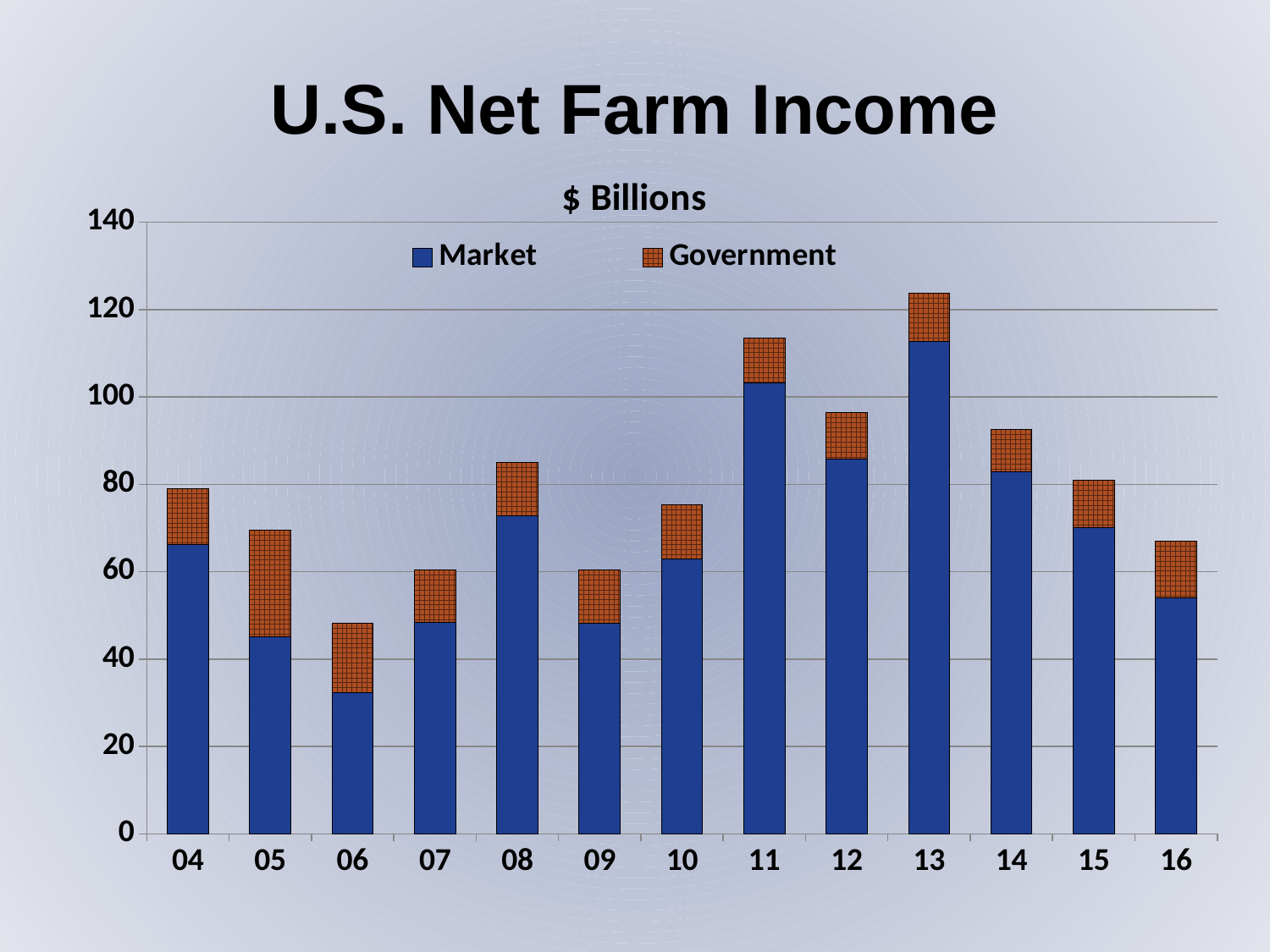
Is the total value for 13 greater or less than 120? greater What kind of chart is shown on the slide? bar chart Which year has the larger total, 11 or 12? 11 Which year has the highest total net farm income? 13 Which year has the lowest total net farm income? 06 Do the total values rise or fall from 13 to 16? fall How many series does the legend list? 2 Is the total value for 06 greater or less than 60? less What unit is given in the chart's subtitle? $ Billions Which year has the largest Market value? 13 How many years are shown on the x axis? 13 Is the Market value for 13 greater or less than 100? greater